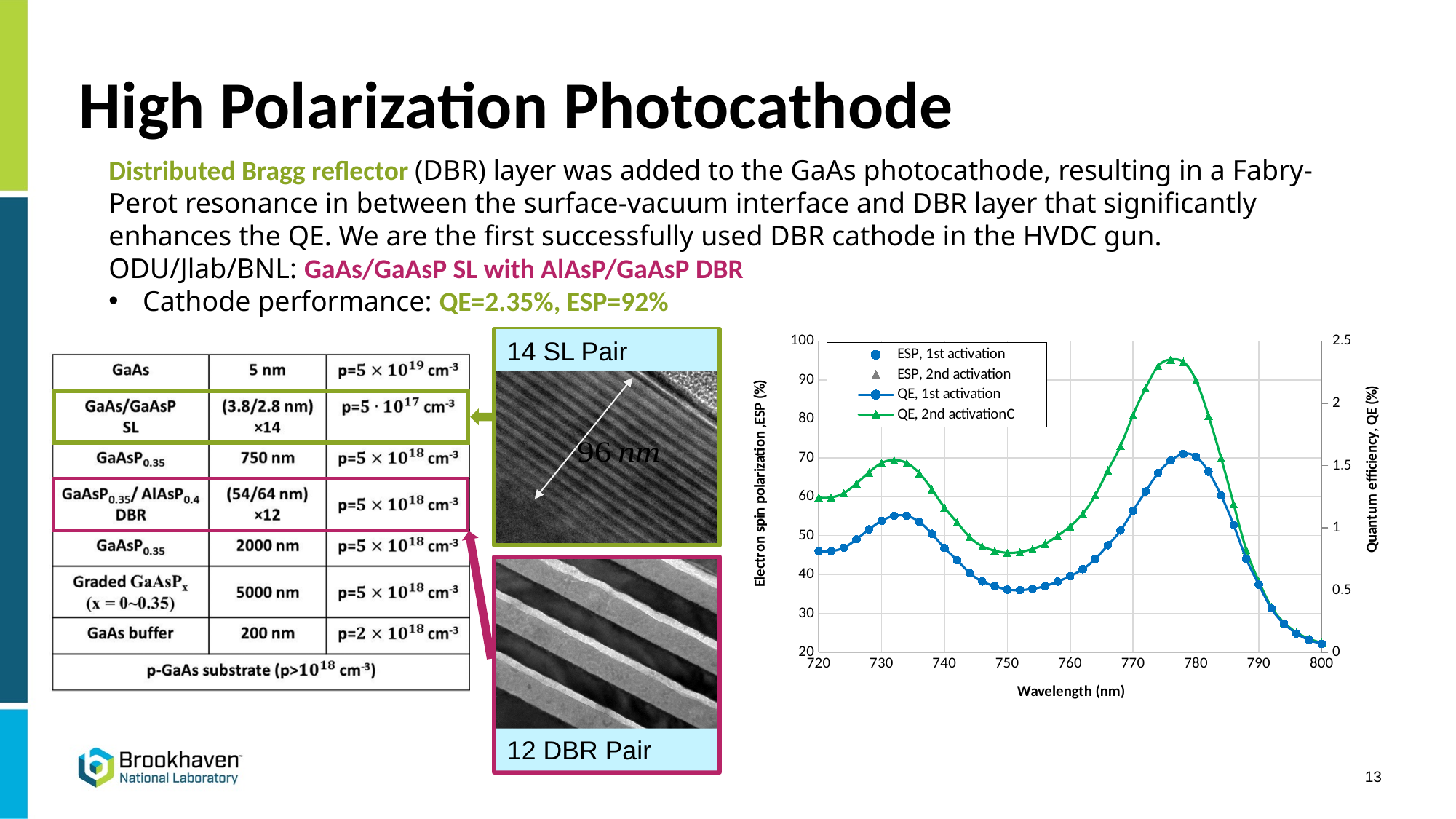
What is the label of the right-hand y axis of the chart? Quantum efficiency, QE (%) What kind of chart is shown on the right of the slide? line chart What is the lowest wavelength value shown on the x axis of the chart? 720 Does the QE, 2nd activation series rise or fall between 780 nm and 800 nm? fall What is the label of the x axis of the chart? Wavelength (nm) Is the peak value of the QE, 1st activation series greater or less than 2 on the right-hand axis? less Which QE series reaches the higher peak value, QE 1st activation or QE 2nd activation? QE, 2nd activation At 750 nm, which series is higher, QE 1st activation or QE 2nd activation? QE, 2nd activation Is the peak value of the QE, 2nd activation series greater or less than 2 on the right-hand axis? greater Is the value of the QE, 2nd activation series at 800 nm greater or less than 0.5 on the right-hand axis? less Does the QE, 2nd activation series rise or fall between 760 nm and 775 nm? rise How many series does the legend of the chart list? 4